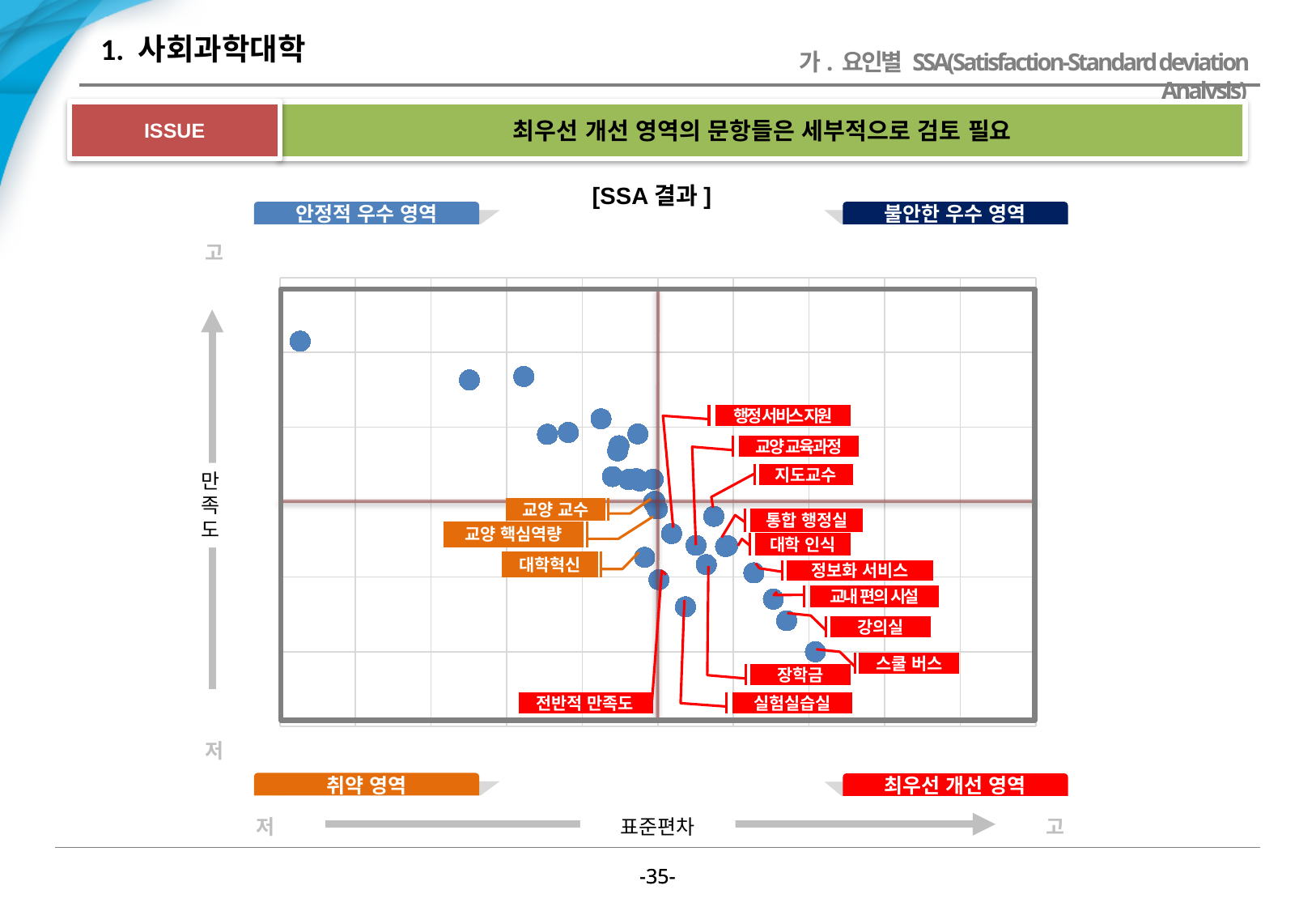
As standard deviation (표준편차) increases along the x axis, do the satisfaction values generally rise or fall? fall Which has the larger standard deviation (표준편차), 스쿨 버스 or 강의실? 스쿨 버스 Which quadrant region does the point labeled 스쿨 버스 fall in? 최우선 개선 영역 How many data points on the chart have a name label attached? 15 Which of the labeled points has the lowest satisfaction (만족도)? 스쿨 버스 Which has the higher satisfaction (만족도), 지도교수 or 장학금? 지도교수 What is the label of the vertical axis of the chart? 만족도 Which of the labeled points has the largest standard deviation (표준편차)? 스쿨 버스 What is the label of the horizontal axis of the chart? 표준편차 What kind of chart is shown under the title [SSA 결과]? scatter plot Which quadrant region does the point labeled 대학혁신 fall in? 취약 영역